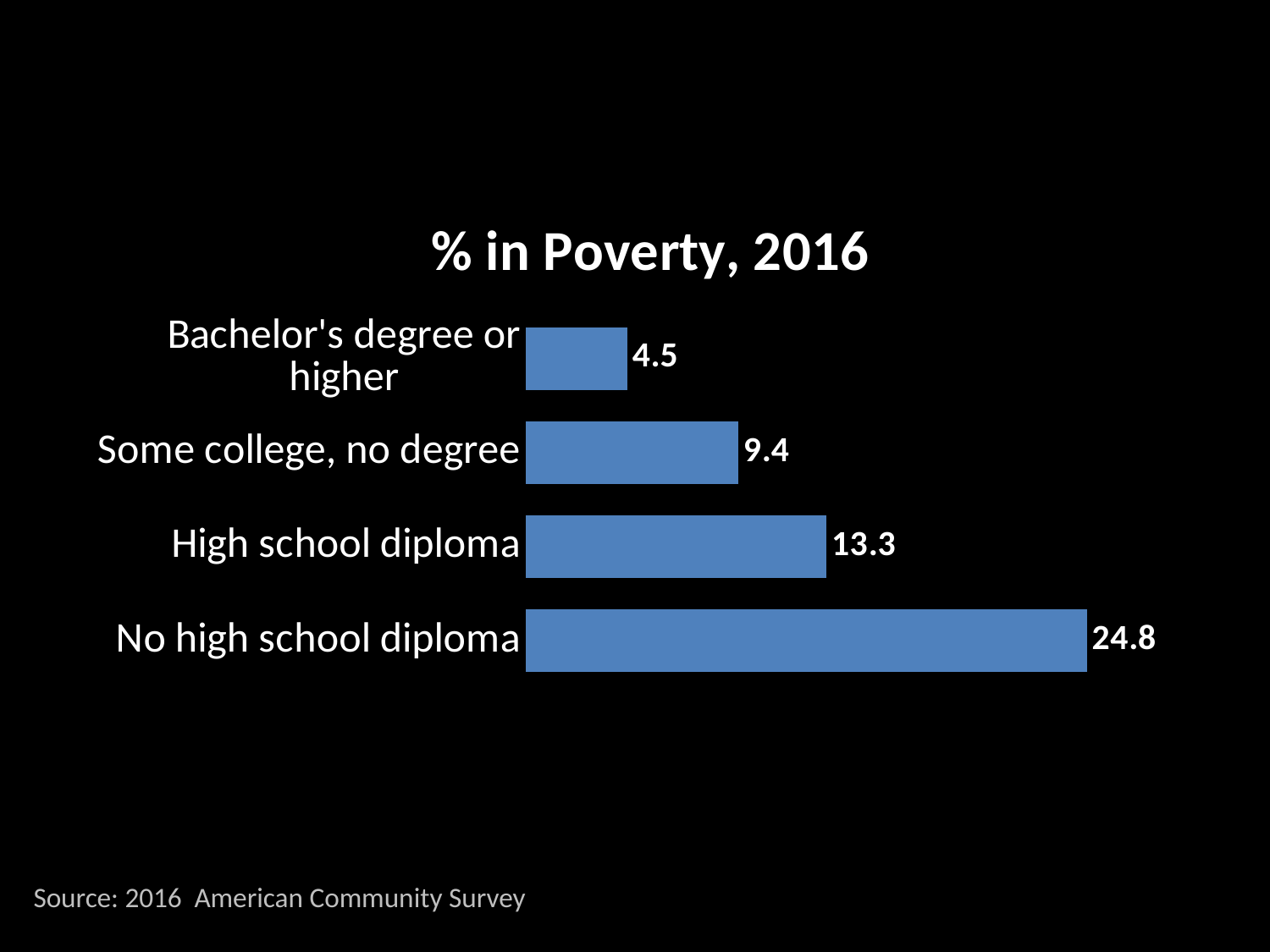
What is the value for Bachelor's degree or higher? 4.5 What is the difference between the values for No high school diploma and High school diploma? 11.5 What is the title of the chart? % in Poverty, 2016 What is the value for No high school diploma? 24.8 Which is larger, the value for High school diploma or the value for Some college, no degree? High school diploma Which category has the lowest value? Bachelor's degree or higher What is the value for Some college, no degree? 9.4 What is the value for High school diploma? 13.3 Which category has the highest value? No high school diploma What kind of chart is shown on the slide? Bar chart What is the difference between the values for Some college, no degree and Bachelor's degree or higher? 4.9 How many categories are shown in the chart? 4